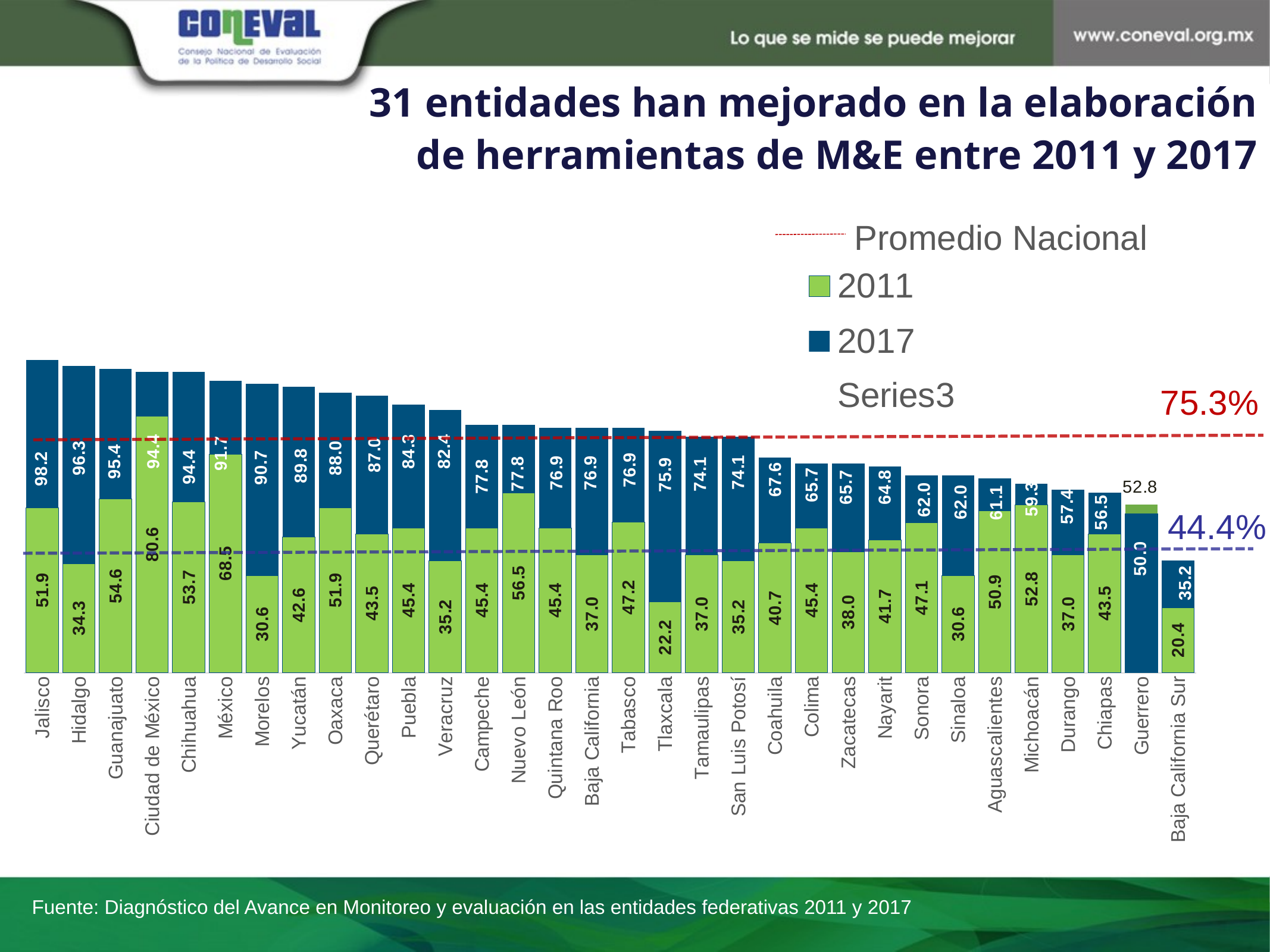
How many entities are shown on the x axis? 32 What is the difference between the 2017 and 2011 values for Jalisco? 46.3 What is the 2011 value for Morelos? 30.6 What kind of chart is shown? Bar chart Which entity has the highest 2017 value? Jalisco Which has the larger 2011 value, Hidalgo or Guanajuato? Guanajuato Do the 2017 values rise or fall from left to right along the x axis? Fall How many entries does the legend list? 4 What is the 2011 value for Tlaxcala? 22.2 What is the difference between the 2017 and 2011 values for Morelos? 60.1 What is the 2017 value for Jalisco? 98.2 Which entity has the lowest 2011 value? Baja California Sur